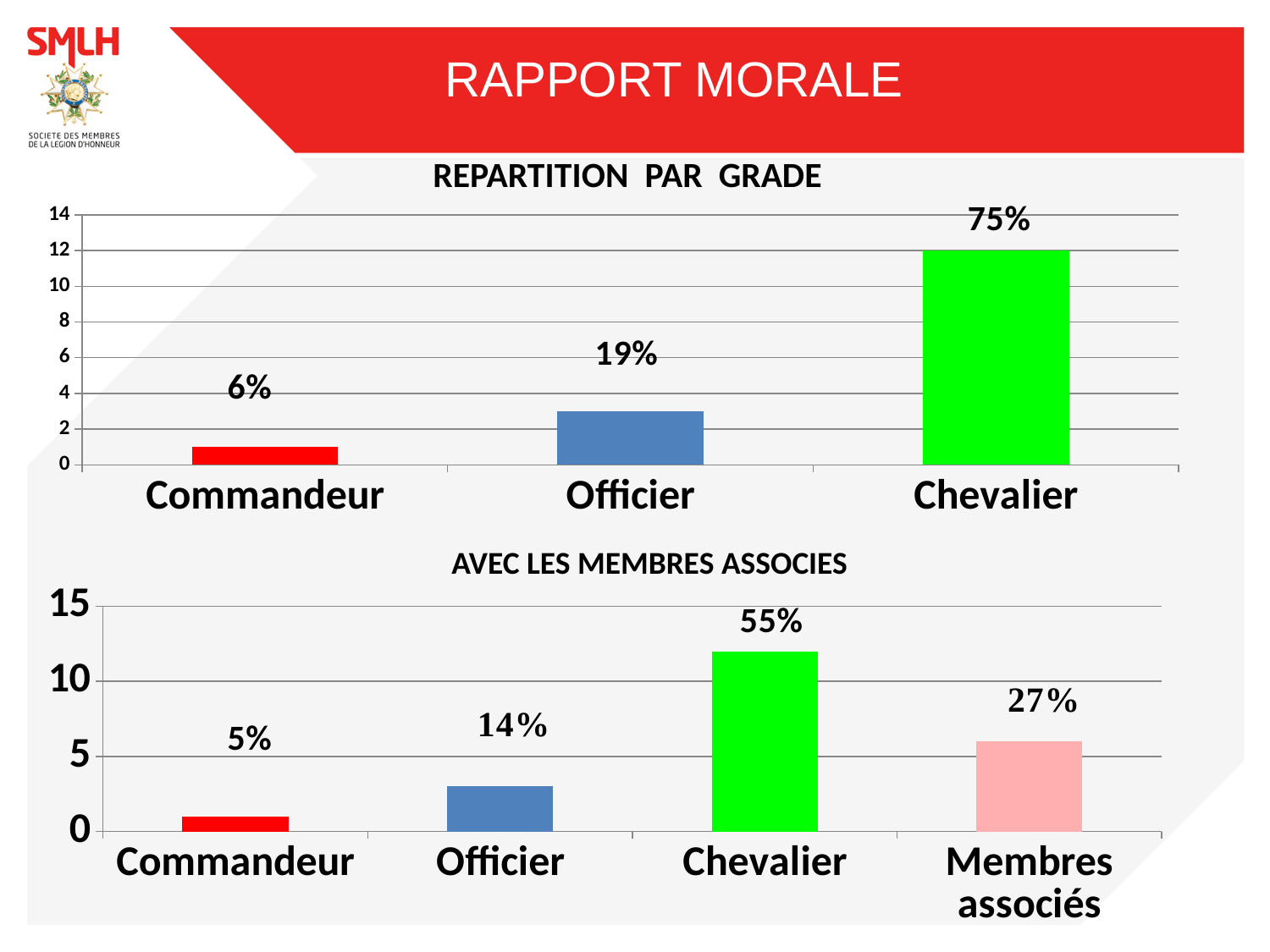
In the bottom chart 'AVEC LES MEMBRES ASSOCIES', which category has the lowest value? Commandeur In the top chart 'REPARTITION PAR GRADE', which grade has the highest value? Chevalier In the top chart 'REPARTITION PAR GRADE', what percentage label is shown for Chevalier? 75% How many categories are shown in the bottom chart 'AVEC LES MEMBRES ASSOCIES'? 4 In the bottom chart 'AVEC LES MEMBRES ASSOCIES', what percentage label is shown for Commandeur? 5% What type of chart is the top chart 'REPARTITION PAR GRADE'? Bar chart In the top chart 'REPARTITION PAR GRADE', what is the difference in percentage points between the Chevalier label and the Officier label? 56 In the bottom chart 'AVEC LES MEMBRES ASSOCIES', which is larger: Officier or Membres associés? Membres associés In the top chart 'REPARTITION PAR GRADE', what percentage label is shown for Officier? 19% In the bottom chart 'AVEC LES MEMBRES ASSOCIES', is the bar for Officier greater or less than 5 on the vertical axis? less In the bottom chart 'AVEC LES MEMBRES ASSOCIES', what percentage label is shown for Membres associés? 27% What is the title of the bottom chart on the slide? AVEC LES MEMBRES ASSOCIES